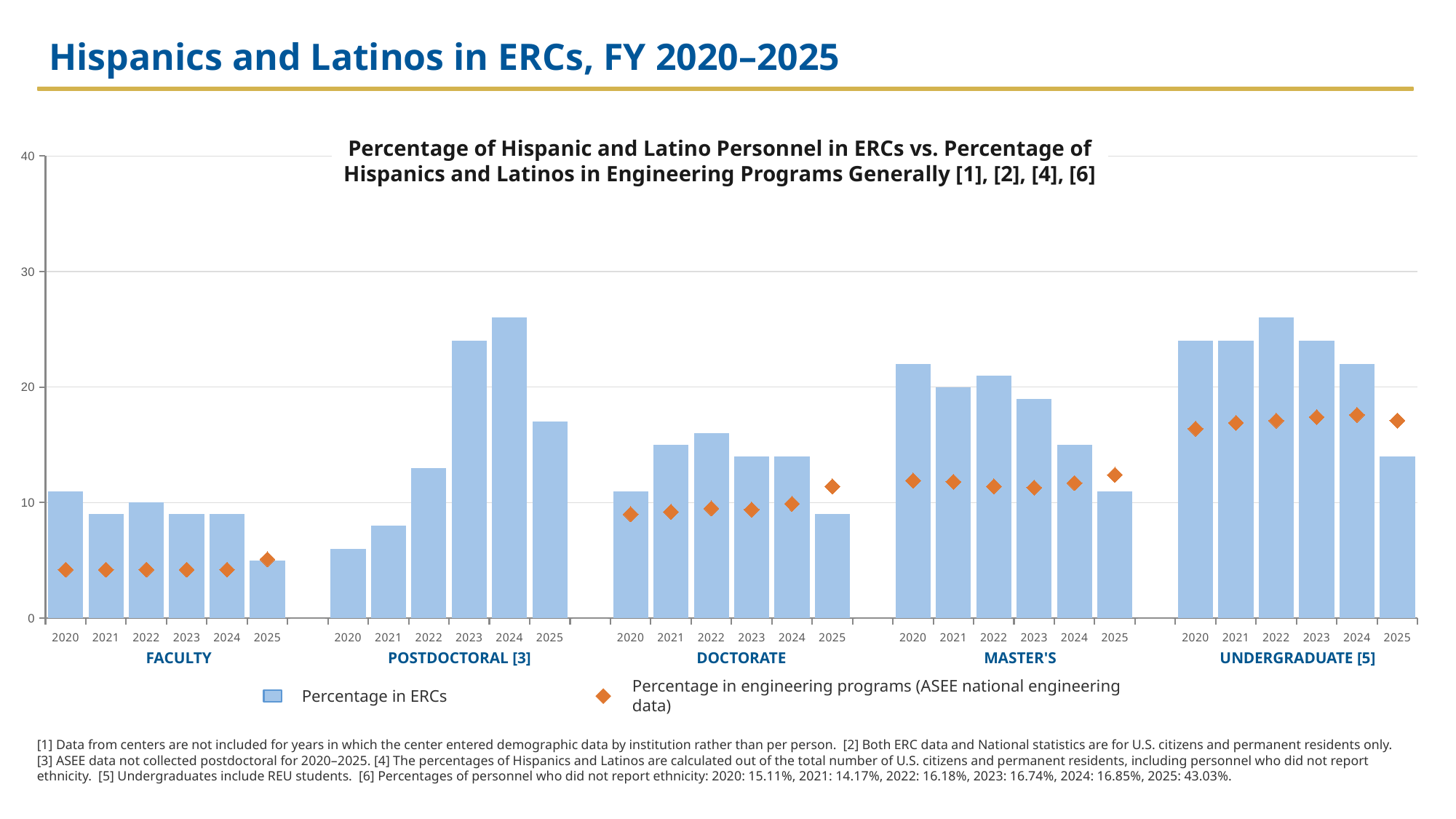
Do the Percentage in ERCs bars for the Postdoctoral group rise or fall from 2020 to 2024? rise Is the Percentage in ERCs for Faculty in 2020 greater or less than 20? less In the Faculty group, which year has the lowest Percentage in ERCs? 2025 How many personnel groups (category groups) are shown along the x axis? 5 Is the Percentage in ERCs for Undergraduate in 2025 greater or less than 10? greater What is the Percentage in ERCs for Faculty in 2022? 10 Which personnel group has no orange diamond markers for the engineering programs series? Postdoctoral How many series does the legend list? 2 Which is larger: the Percentage in ERCs for Undergraduate in 2022 or in 2025? 2022 Is the Percentage in ERCs for Postdoctoral in 2024 greater or less than 20? greater What kind of chart is shown on the slide? bar chart In the Postdoctoral group, which year has the highest Percentage in ERCs? 2024